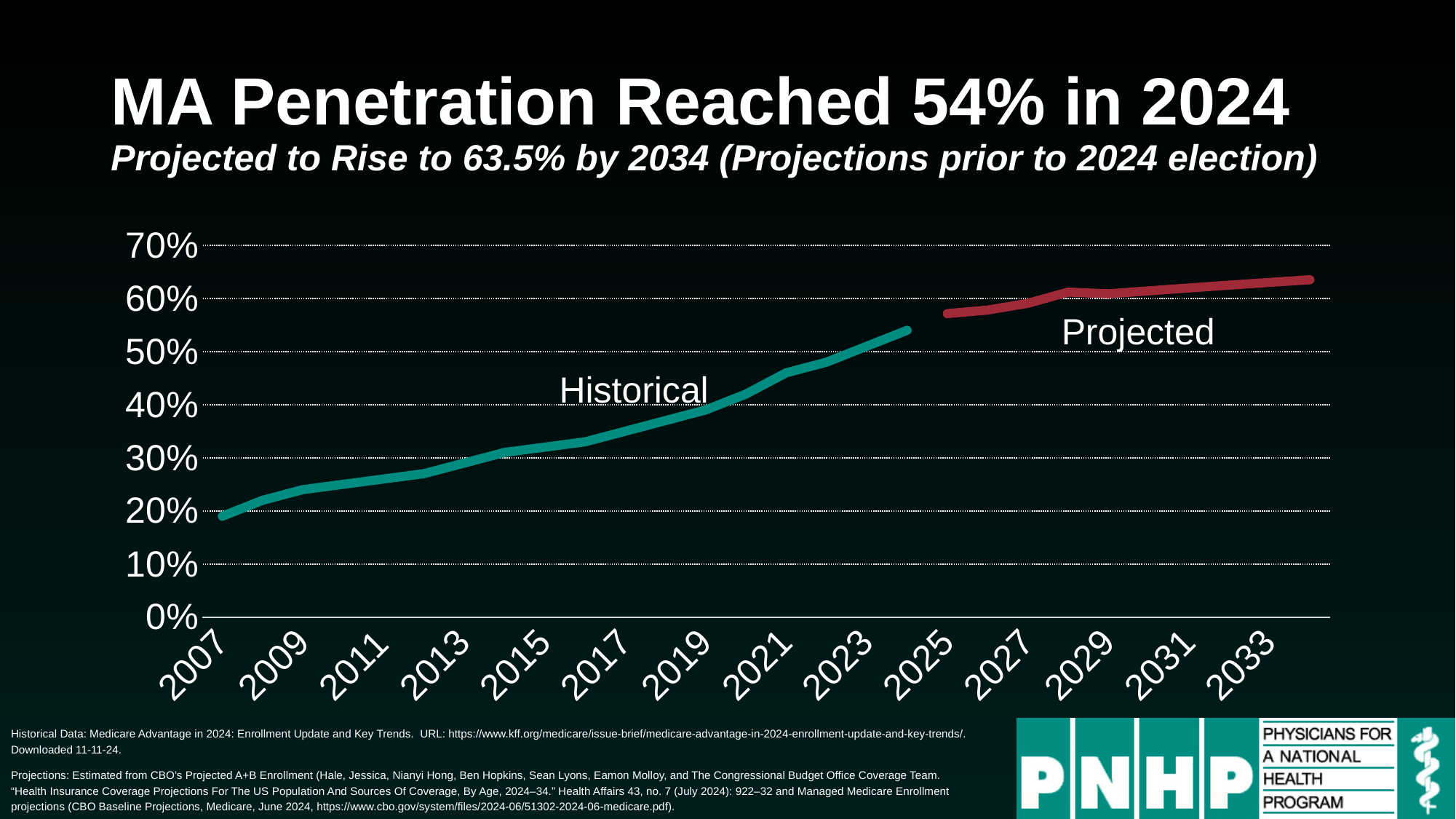
What kind of chart is shown on the slide? line chart Which is larger, the value for 2033 or the value for 2007? 2033 How many line series are shown on the chart? 2 Does MA penetration rise or fall from 2007 to 2033? rise According to the slide, what was MA penetration in 2024? 54% According to the slide, what is MA penetration projected to reach by 2034? 63.5% What are the two series labeled on the chart? Historical and Projected Which year has the lowest MA penetration on the chart? 2007 Is the value for 2021 greater or less than 40%? greater